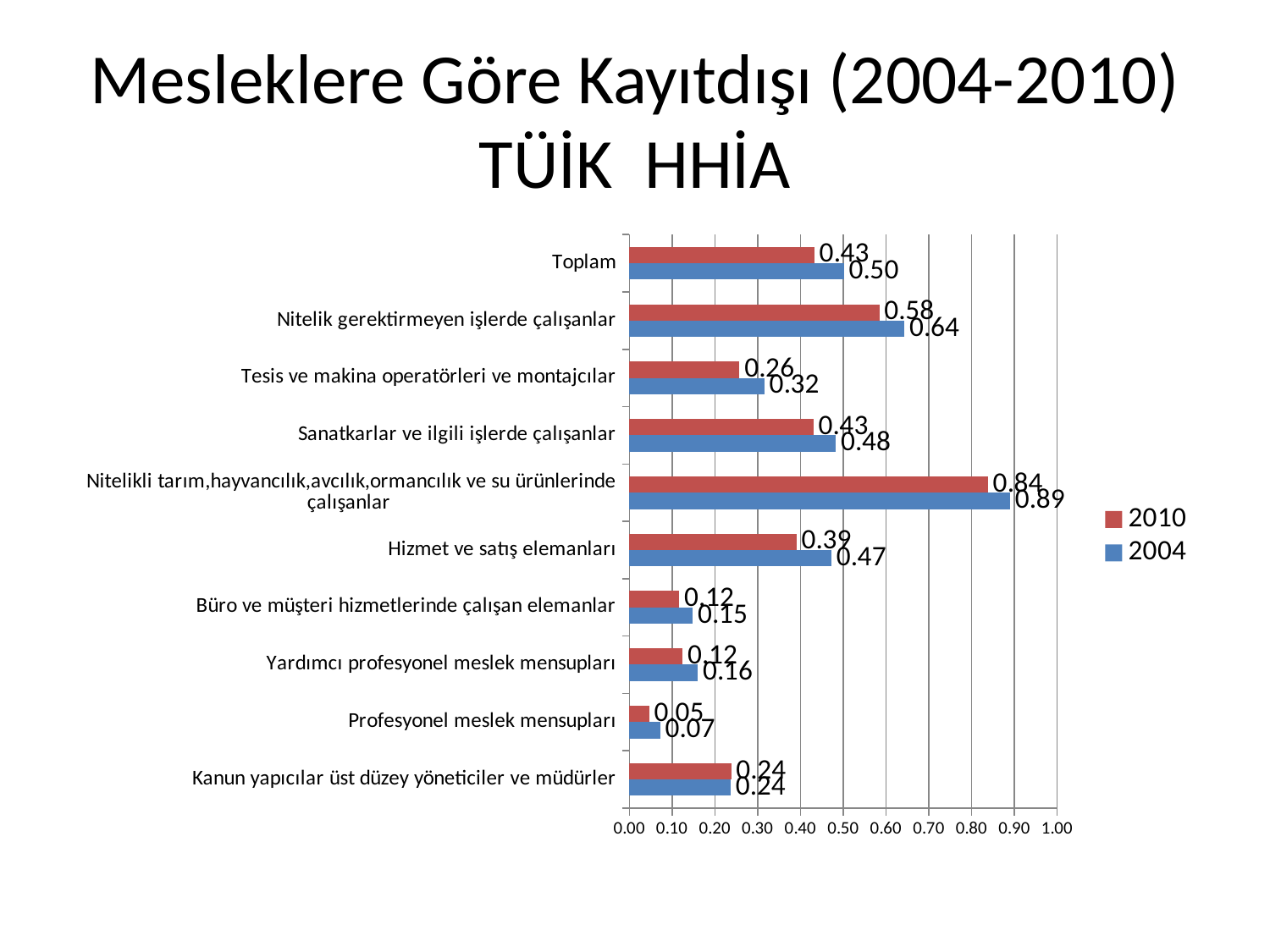
Which category has the highest 2004 value? Nitelikli tarım,hayvancılık,avcılık,ormancılık ve su ürünlerinde çalışanlar How many series does the legend list? 2 Which is larger for Sanatkarlar ve ilgili işlerde çalışanlar: the 2004 value or the 2010 value? 2004 Which colour represents the 2010 series in the legend? red How many categories are shown on the chart? 10 What is the difference between the 2004 and 2010 values for Tesis ve makina operatörleri ve montajcılar? 0.06 Which category has the lowest 2010 value? Profesyonel meslek mensupları What is the 2010 value for Toplam? 0.43 What is the 2004 value for Kanun yapıcılar üst düzey yöneticiler ve müdürler? 0.24 What is the 2004 value for Nitelik gerektirmeyen işlerde çalışanlar? 0.64 What kind of chart is shown on the slide? bar chart What is the 2010 value for Hizmet ve satış elemanları? 0.39